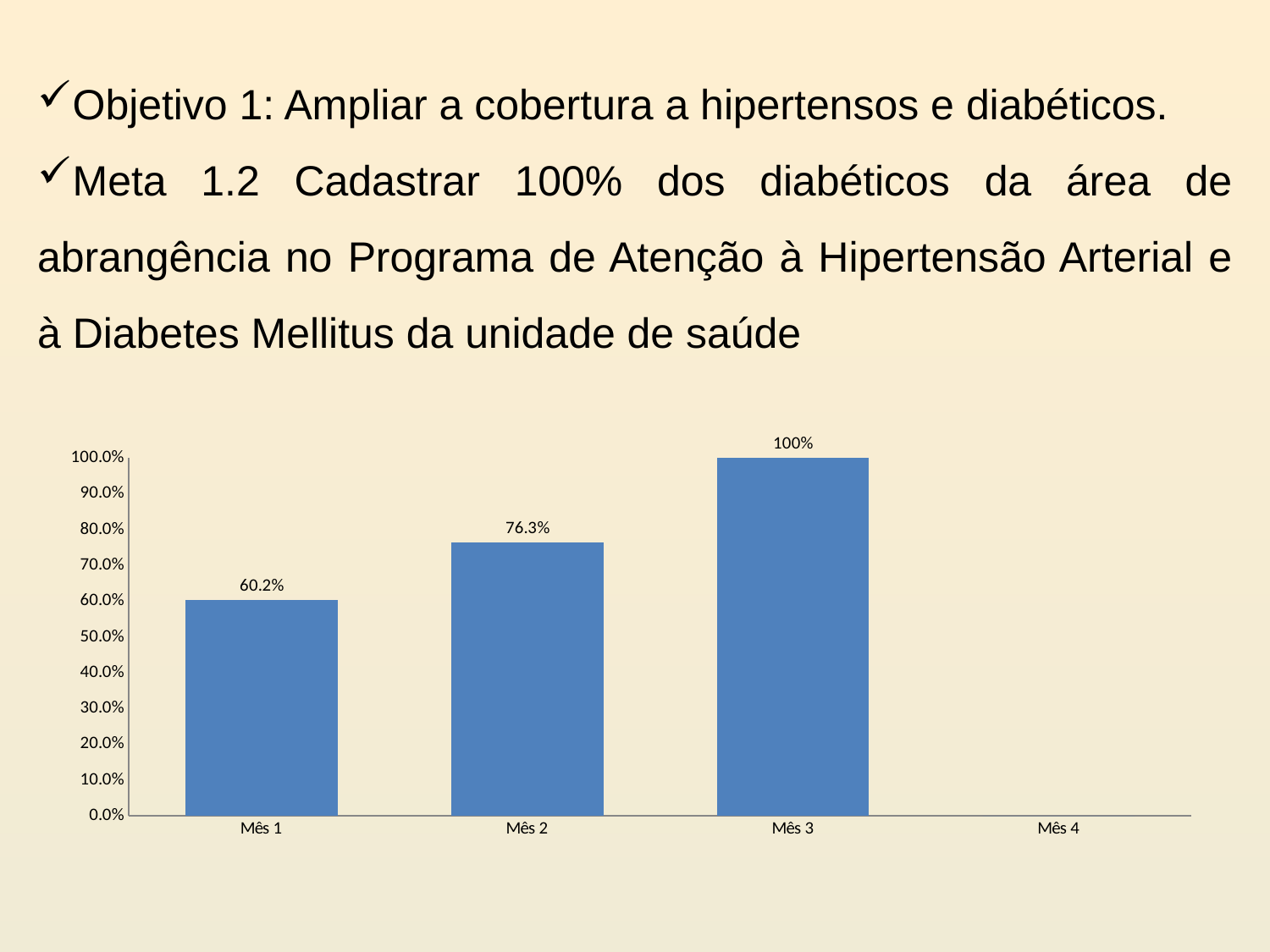
Of Mês 1, Mês 2 and Mês 3, which has the lowest value? Mês 1 What is the difference between the values for Mês 3 and Mês 2? 23.7 percentage points Is the value for Mês 2 greater or less than 70.0%? greater What is the value for Mês 2? 76.3% What kind of chart is shown on the slide? Bar chart What is the difference between the values for Mês 2 and Mês 1? 16.1 percentage points What is the value for Mês 1? 60.2% What is the value for Mês 3? 100% Which is larger, the value for Mês 1 or the value for Mês 2? Mês 2 Which month has the highest value in the chart? Mês 3 How many category labels are shown on the x axis? 4 Do the values rise or fall from Mês 1 to Mês 3? Rise